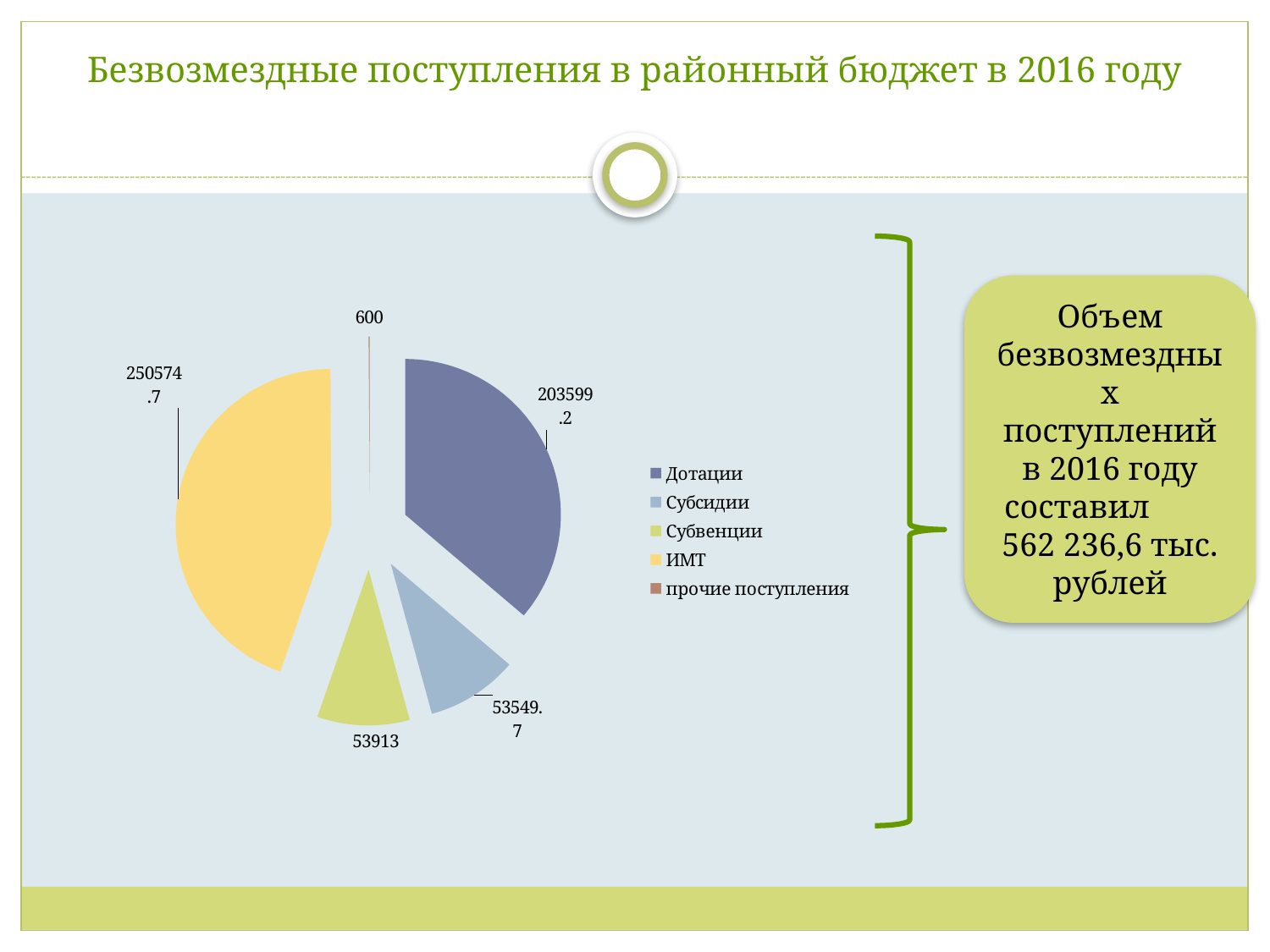
What is the value for Субвенции? 53913 What is the value for прочие поступления? 600 Which is larger, the value for ИМТ or the value for Дотации? ИМТ What is the value for ИМТ? 250574.7 What is the title of the slide containing the chart? Безвозмездные поступления в районный бюджет в 2016 году How many categories does the pie chart show? 5 What is the difference between the values for ИМТ and Дотации? 46975.5 What kind of chart is shown on the slide? pie chart Which category has the smallest slice of the pie? прочие поступления What is the value for Дотации? 203599.2 Which category has the largest slice of the pie? ИМТ What is the value for Субсидии? 53549.7